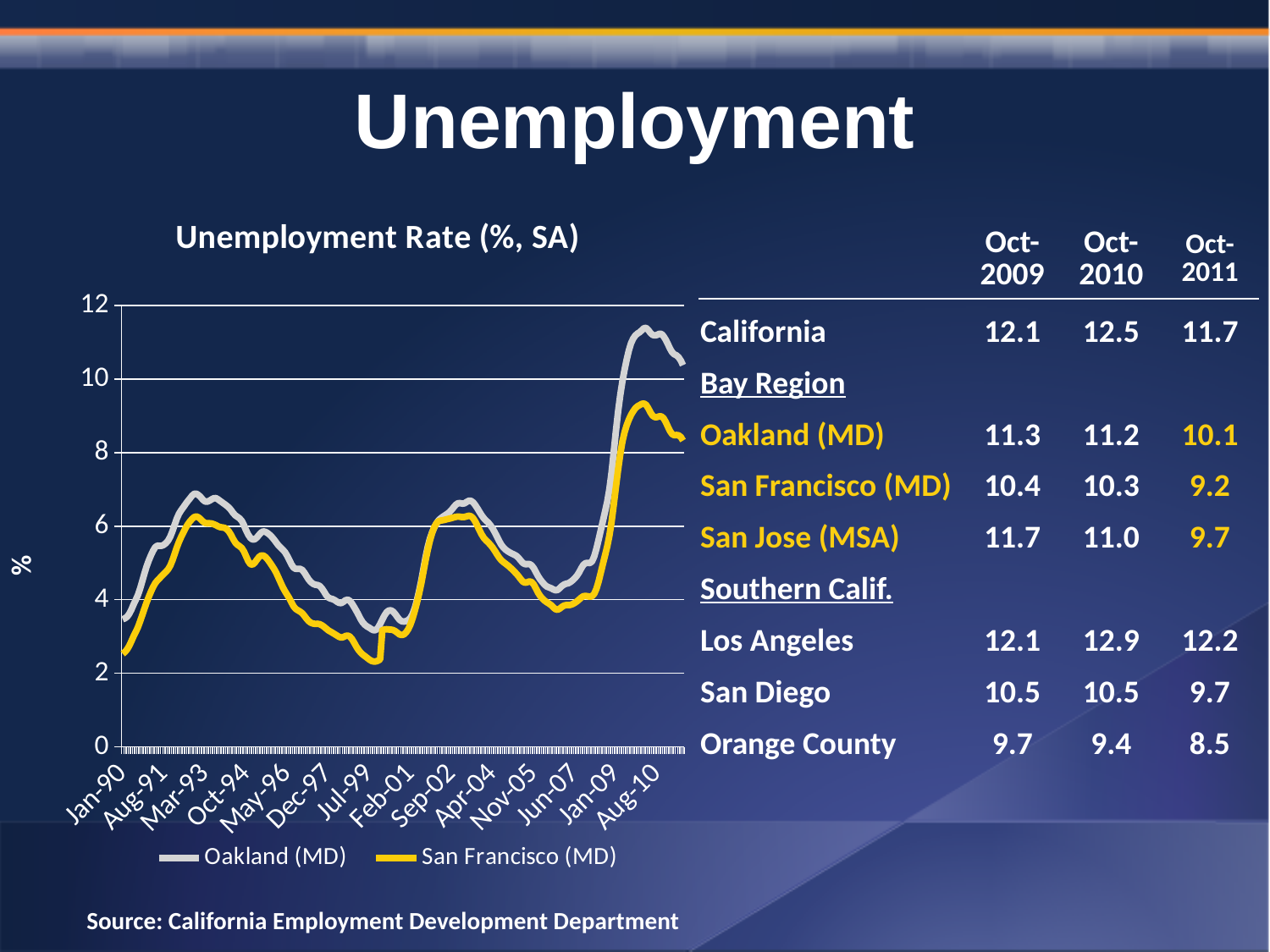
Between Mar-93 and Jul-99, does the Oakland (MD) unemployment rate generally rise or fall? fall What kind of chart is shown on the slide? line chart Is the value for San Francisco (MD) at Jan-90 greater or less than 4? less Which two series are plotted in the chart? Oakland (MD) and San Francisco (MD) At Aug-10, which series has the higher unemployment rate, Oakland (MD) or San Francisco (MD)? Oakland (MD) What is the title of the chart? Unemployment Rate (%, SA) Is the peak value for San Francisco (MD) around 2010 greater or less than 8? greater How many series does the chart's legend list? 2 Is the peak value for Oakland (MD) around 2010 greater or less than 10? greater Between Jan-09 and Aug-10, do the unemployment rates in the chart rise or fall? rise